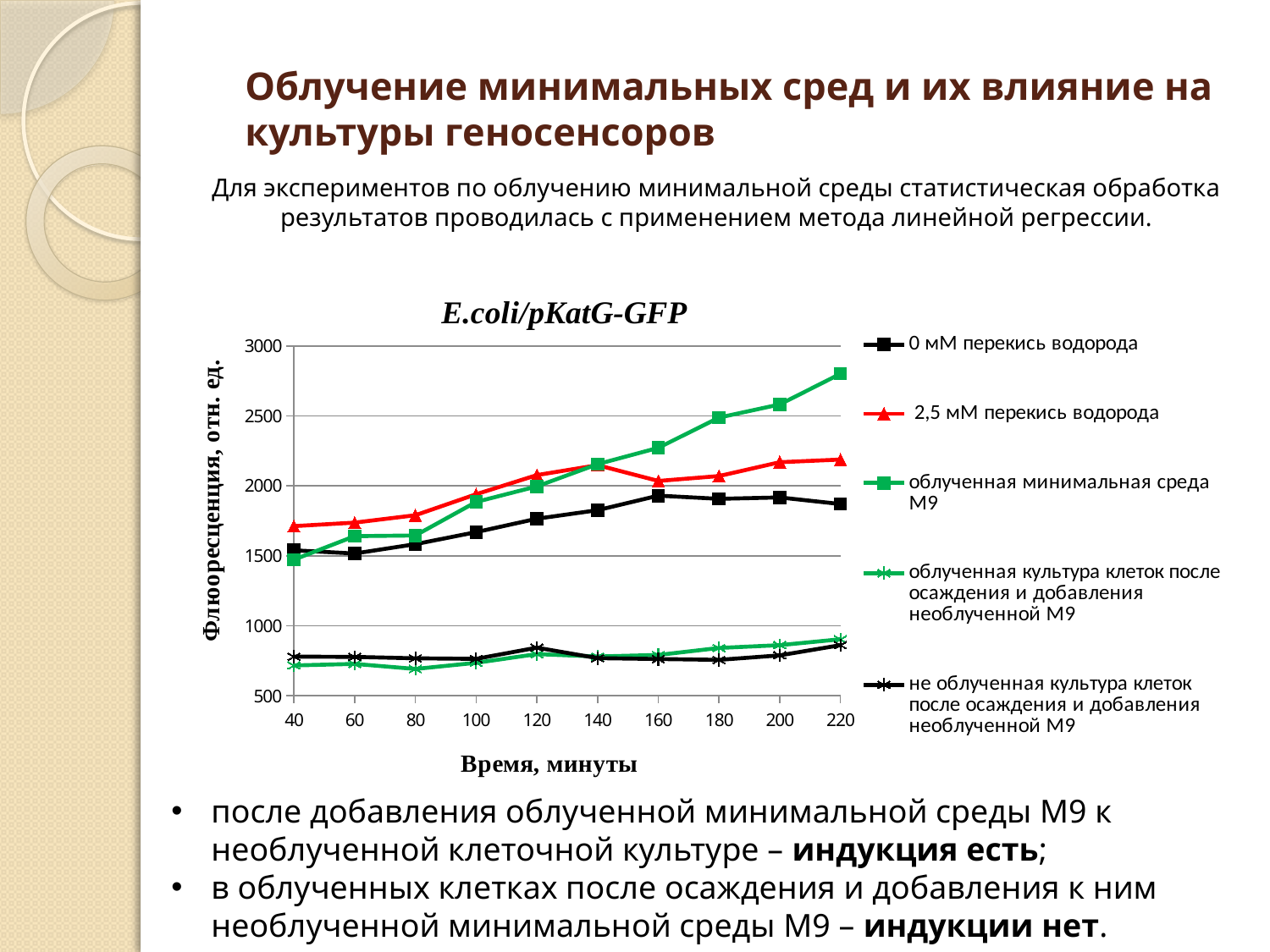
How many series does the legend of the chart list? 5 Is the value for "2,5 мМ перекись водорода" at 140 minutes greater or less than 2000? greater What kind of chart is shown on the slide? line chart Is the value for "не облученная культура клеток после осаждения и добавления необлученной M9" at 100 minutes greater or less than 1000? less Which series has the highest value at 220 minutes? облученная минимальная среда M9 Is the value for "0 мМ перекись водорода" at 40 minutes greater or less than 2000? less What is the label of the y axis of the chart? Флюоресценция, отн. ед. What is the title of the chart? E.coli/pKatG-GFP At 220 minutes, which is larger: the value for "2,5 мМ перекись водорода" or for "0 мМ перекись водорода"? 2,5 мМ перекись водорода Does the series "облученная минимальная среда M9" rise or fall as time increases along the x axis? rise How many time points are plotted along the x axis of the chart? 10